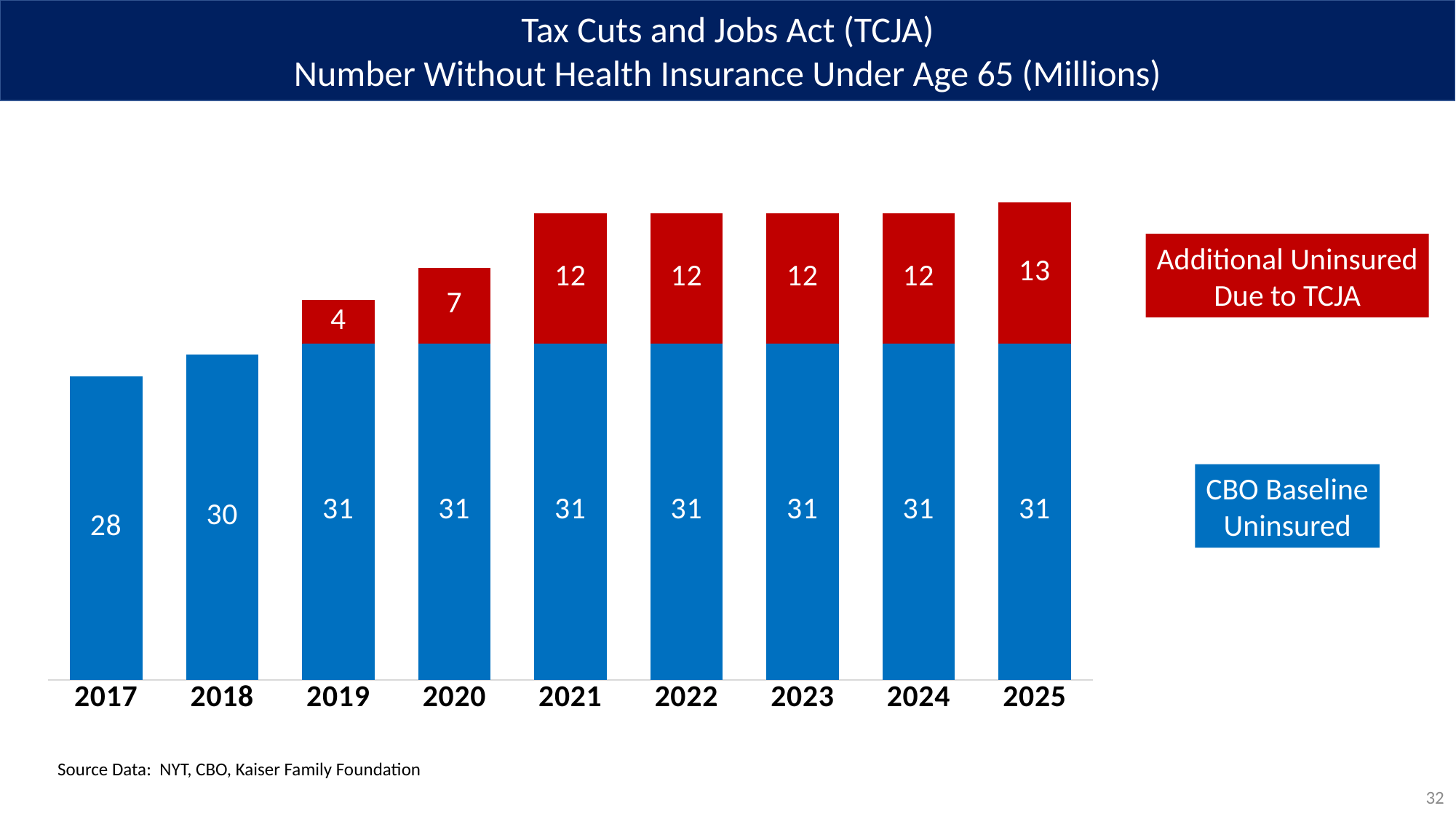
Which year has the lowest CBO Baseline Uninsured value? 2017 What is the Additional Uninsured Due to TCJA value for 2020? 7 What kind of chart is shown on the slide? Stacked bar chart How many years are shown on the x axis? 9 What is the Additional Uninsured Due to TCJA value for 2025? 13 Which year has the highest Additional Uninsured Due to TCJA value? 2025 What is the CBO Baseline Uninsured value for 2017? 28 What is the total of the stacked bar for 2019? 35 What is the difference between the Additional Uninsured Due to TCJA values for 2021 and 2019? 8 What is the total of the stacked bar for 2021? 43 Which is larger, the Additional Uninsured Due to TCJA value for 2020 or for 2019? 2020 What is the CBO Baseline Uninsured value for 2018? 30